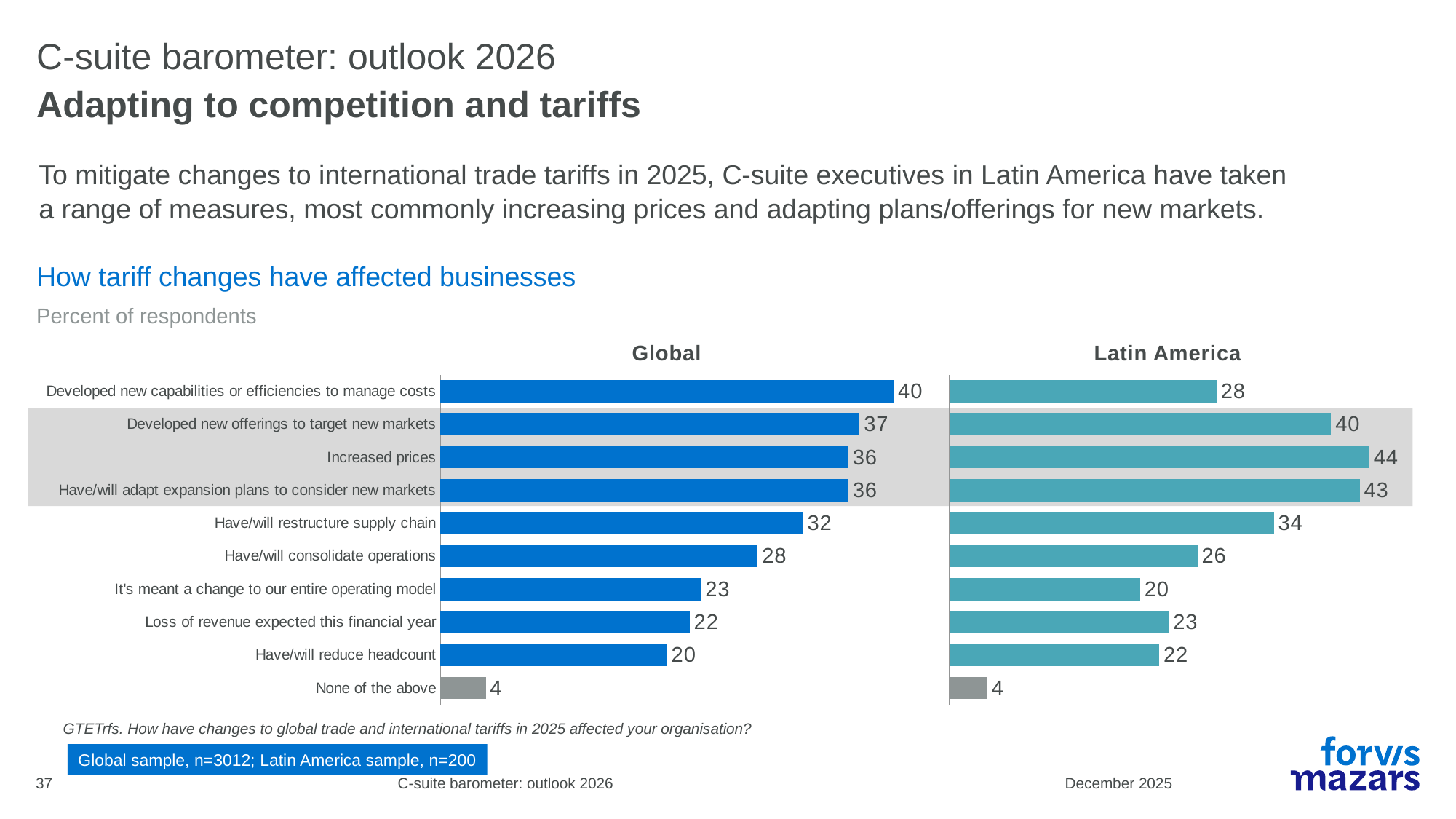
What type of chart is used to show how tariff changes have affected businesses? Bar chart In the Latin America chart, what is the value for 'Have/will adapt expansion plans to consider new markets'? 43 What is the difference between the Latin America and Global values for 'Increased prices'? 8 In the Global chart, which category has the highest value? Developed new capabilities or efficiencies to manage costs What is the title of the chart section on the slide? How tariff changes have affected businesses In the Global chart, what percent of respondents said they developed new capabilities or efficiencies to manage costs? 40 Which is larger for 'Have/will restructure supply chain': the Global value or the Latin America value? Latin America Which is larger for 'Have/will consolidate operations': the Global value or the Latin America value? Global In the Global chart, which category has the lowest value? None of the above In the Latin America chart, which category has the highest value? Increased prices In the Latin America chart, what percent of respondents said they increased prices? 44 How many categories are shown in the Global chart? 10